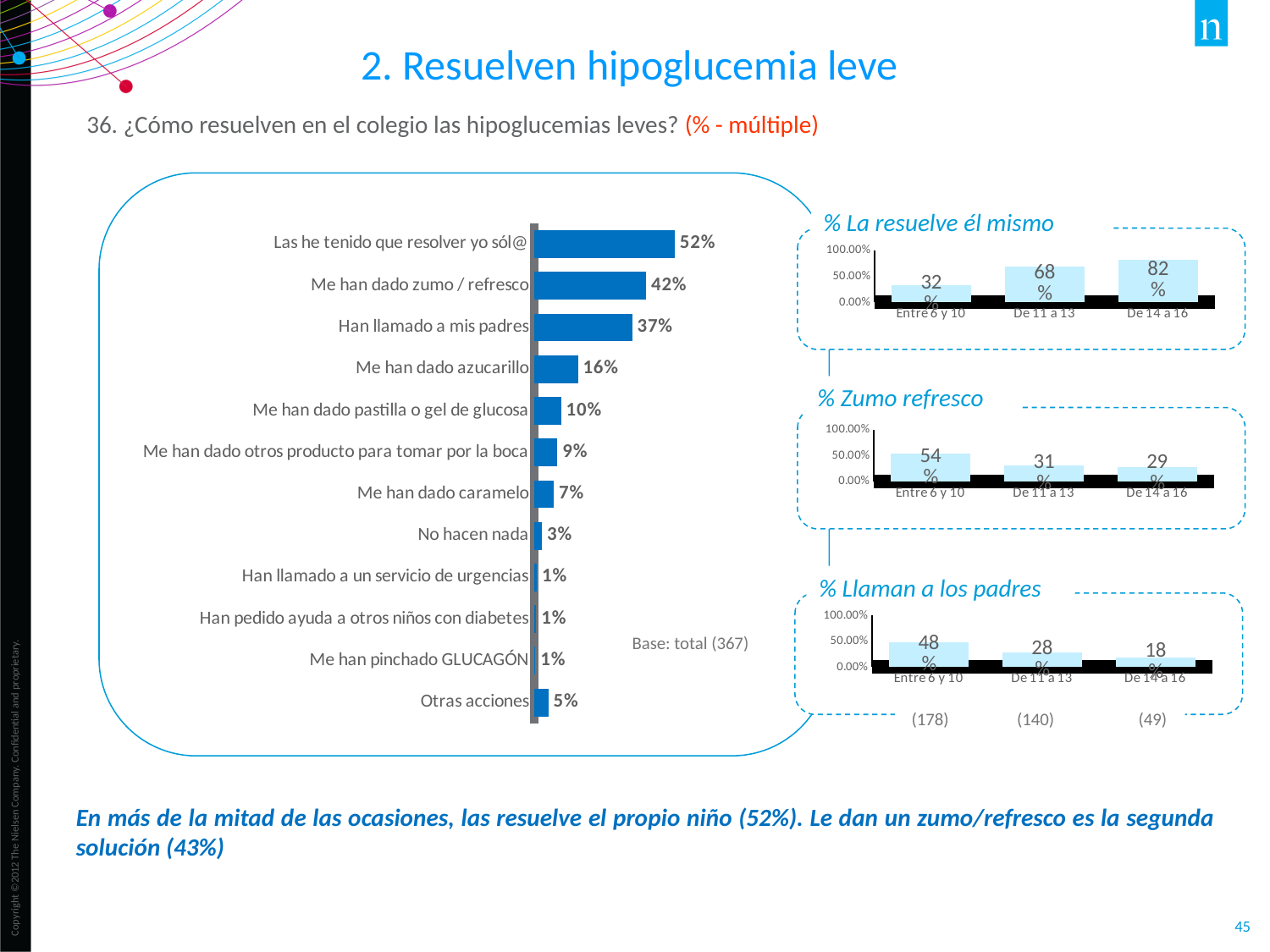
How many categories does the main bar chart on the left show? 12 In the '% La resuelve él mismo' chart, what is the value for 'De 14 a 16'? 82% In the '% Llaman a los padres' chart, is the value for 'Entre 6 y 10' greater or less than 50.00%? less What type of chart is the main chart on the left? Bar chart In the main bar chart on the left, what is the value for 'Las he tenido que resolver yo sól@'? 52% In the main bar chart on the left, what is the difference between 'Me han dado zumo / refresco' and 'Han llamado a mis padres'? 5% In the '% Llaman a los padres' chart, what is the difference between 'Entre 6 y 10' and 'De 14 a 16'? 30% In the '% Zumo refresco' chart, which age group has the highest value? Entre 6 y 10 In the '% La resuelve él mismo' chart, do the values rise or fall from 'Entre 6 y 10' to 'De 14 a 16'? Rise In the main bar chart on the left, which category has the highest value? Las he tenido que resolver yo sól@ In the main bar chart on the left, what is the value for 'Me han dado azucarillo'? 16% In the main bar chart on the left, which is larger: 'Me han dado caramelo' or 'Otras acciones'? Me han dado caramelo